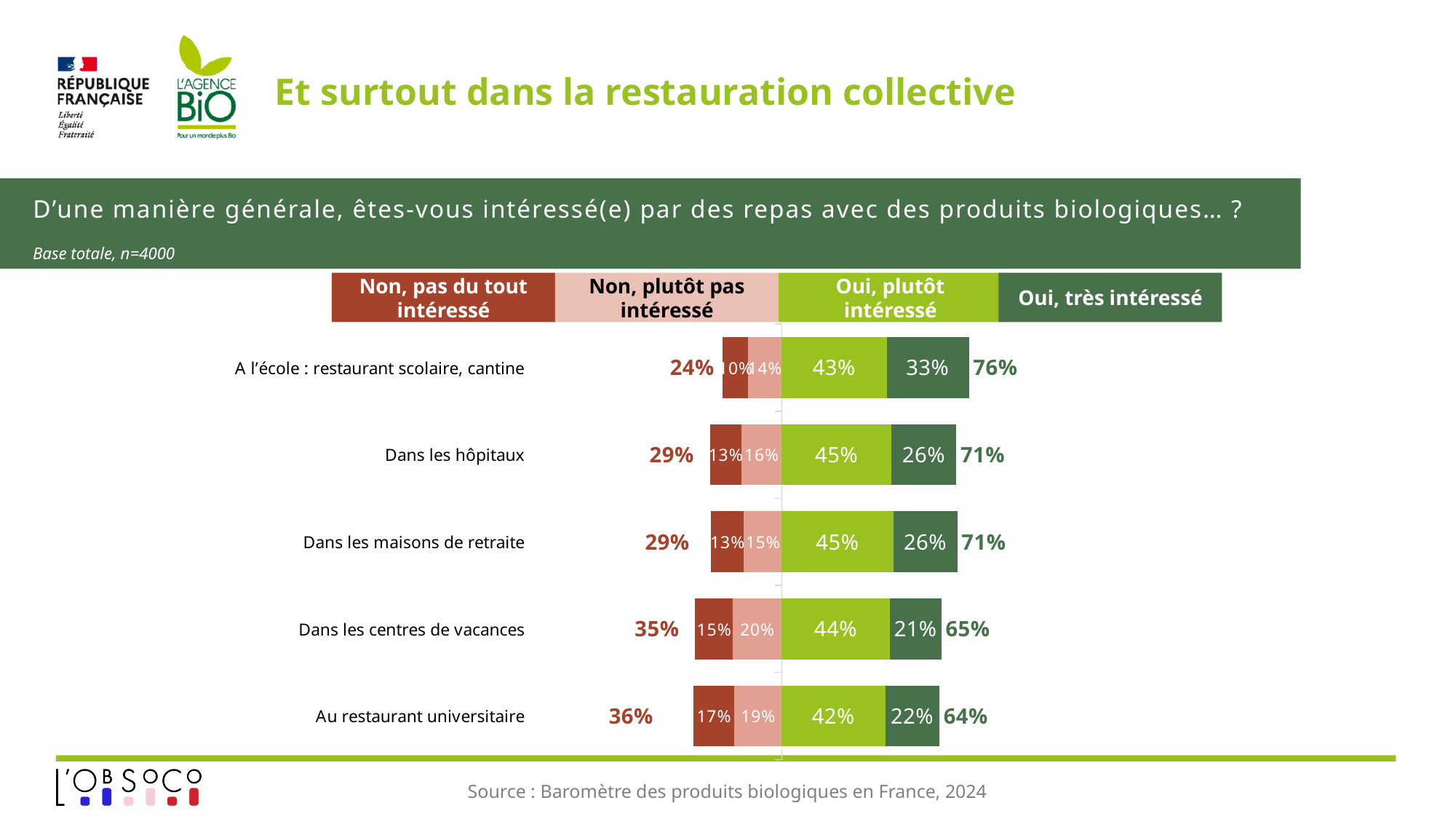
How many categories (types of collective catering) are shown in the chart? 5 How many response series does the legend list? 4 Which category has the highest combined "Oui" share? A l'école : restaurant scolaire, cantine What is the "Non, plutôt pas intéressé" value for "Dans les centres de vacances"? 20% Which category has the lowest "Oui, très intéressé" value? Dans les centres de vacances What colour represents the "Oui, très intéressé" series? Dark green What percentage of respondents are "Oui, très intéressé" for "A l'école : restaurant scolaire, cantine"? 33% What is the combined "Non" total shown for "Dans les hôpitaux"? 29% What is the difference between the "Oui, très intéressé" values for "A l'école : restaurant scolaire, cantine" and "Au restaurant universitaire"? 11 percentage points What kind of chart is shown on the slide? Stacked bar chart What is the "Non, pas du tout intéressé" value for "Au restaurant universitaire"? 17% Which has a higher "Oui, plutôt intéressé" value: "Dans les hôpitaux" or "Au restaurant universitaire"? Dans les hôpitaux